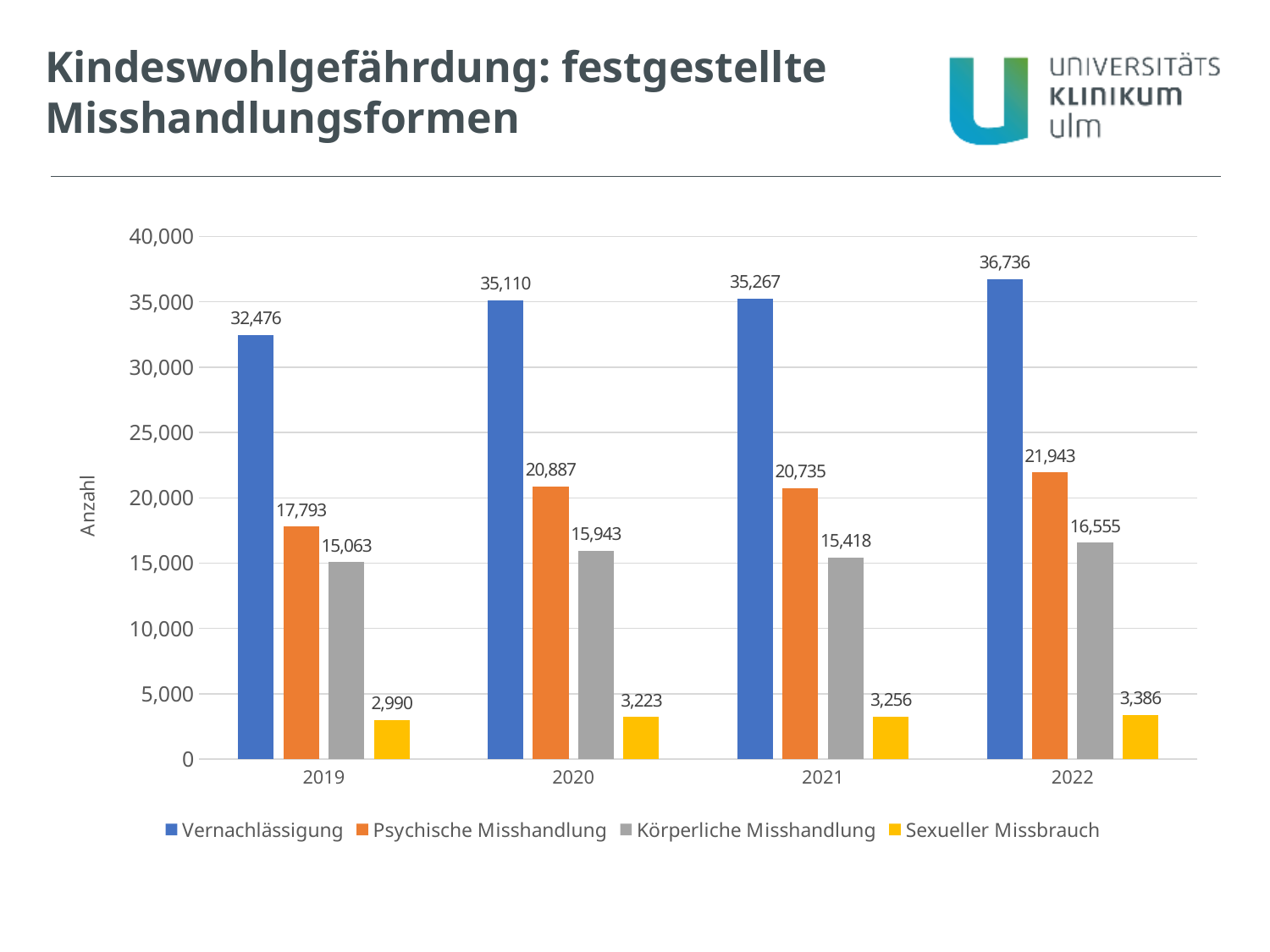
What is the value for Körperliche Misshandlung in 2021? 15,418 What is the value for Sexueller Missbrauch in 2019? 2,990 In which year is the value for Körperliche Misshandlung lowest? 2019 What kind of chart is shown on the slide? bar chart What is the value for Psychische Misshandlung in 2020? 20,887 In which year is the value for Vernachlässigung highest? 2022 What is the value for Vernachlässigung in 2022? 36,736 Is the value for Vernachlässigung in 2019 greater or less than 30,000? greater Which is larger: Psychische Misshandlung in 2020 or in 2021? 2020 How many series does the legend list? 4 What is the difference between the Vernachlässigung values for 2022 and 2019? 4,260 How many years are shown on the x axis? 4